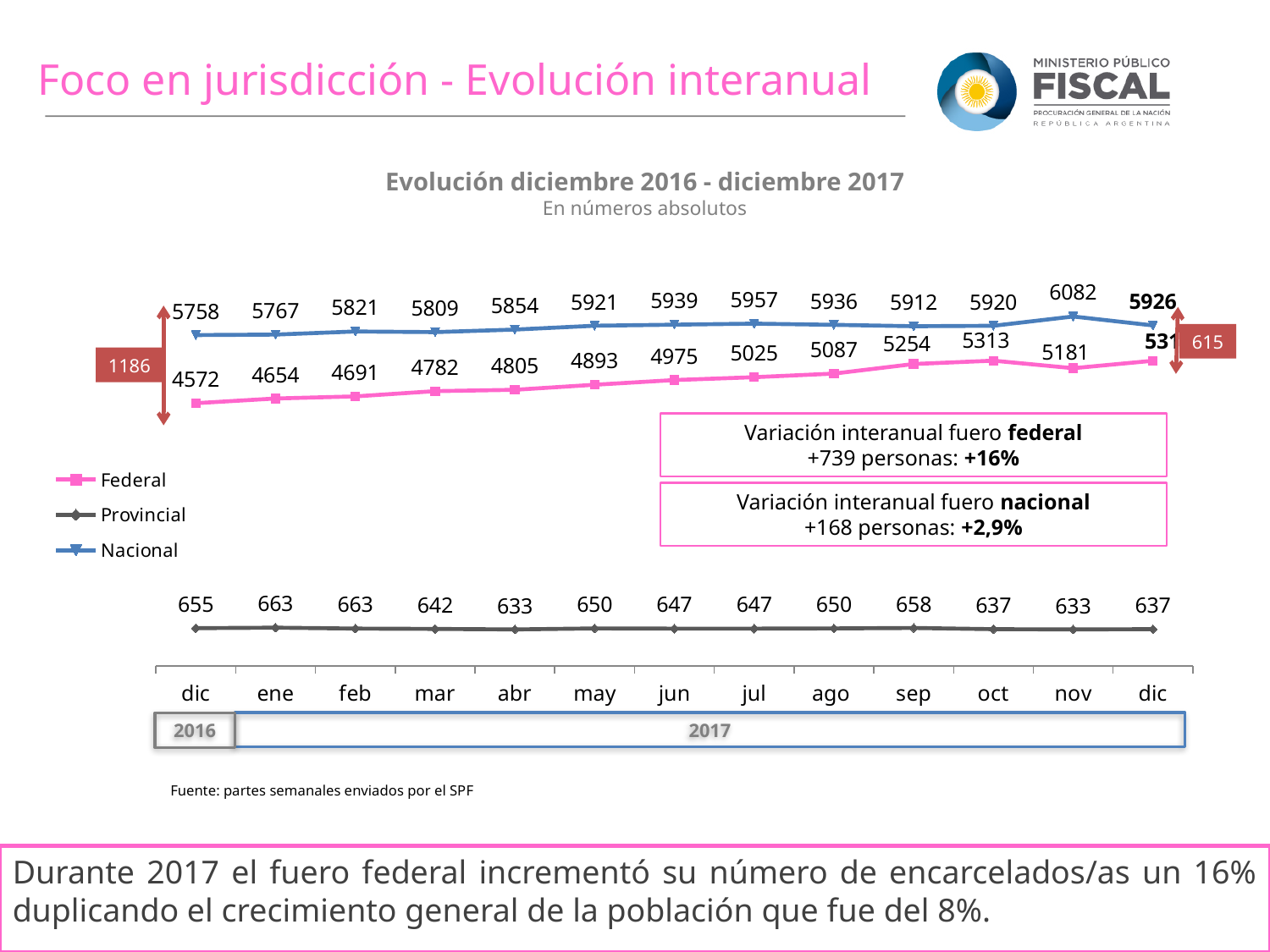
What kind of chart is shown on the slide? line chart In which month does the Nacional series reach its highest value? nov What is the Federal value for sep 2017? 5254 How many series does the chart's legend list? 3 What colour is the Federal series line in the chart? pink What is the Nacional value for nov 2017? 6082 In which month is the Federal series at its lowest value? dic 2016 Which is larger for the Federal series: the value in oct or the value in nov? oct What is the difference between the Nacional value in nov 2017 and in dic 2016? 324 How many months (data points) are plotted along the x axis? 13 Does the Federal series generally rise or fall from dic 2016 to dic 2017? rise What is the Provincial value for abr 2017? 633